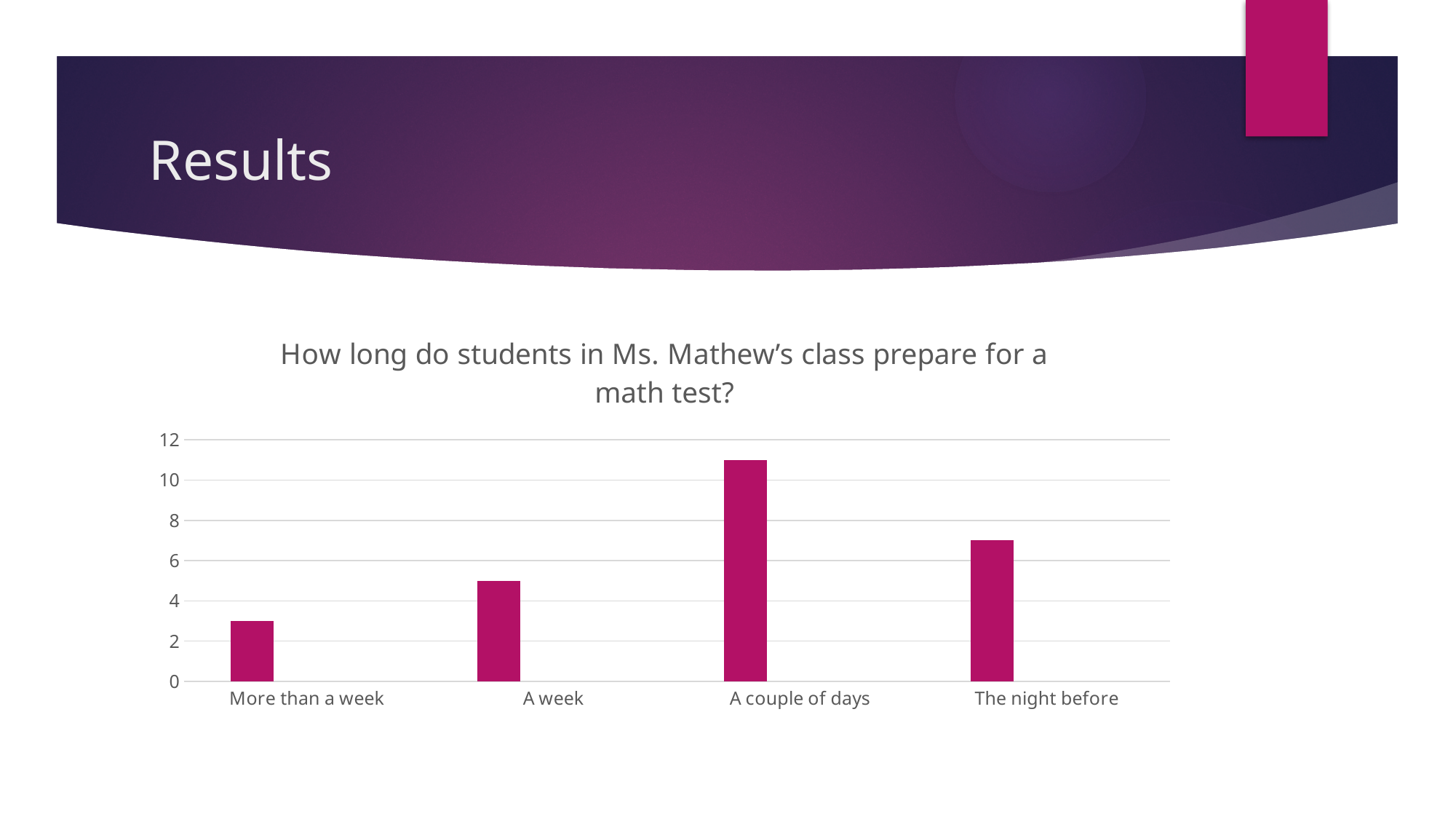
Which is larger, the value for "More than a week" or the value for "A couple of days"? A couple of days Which is larger, the value for "The night before" or the value for "A week"? The night before Is the value for "A week" greater or less than 6? less Is the value for "The night before" greater or less than 6? greater What is the highest value shown on the y axis of the chart? 12 Which category has the highest bar? A couple of days How many categories are shown on the x axis of the chart? 4 What kind of chart is shown on the slide? bar chart What is the title of the chart? How long do students in Ms. Mathew's class prepare for a math test? Which category has the lowest bar? More than a week Is the value for "More than a week" greater or less than 4? less